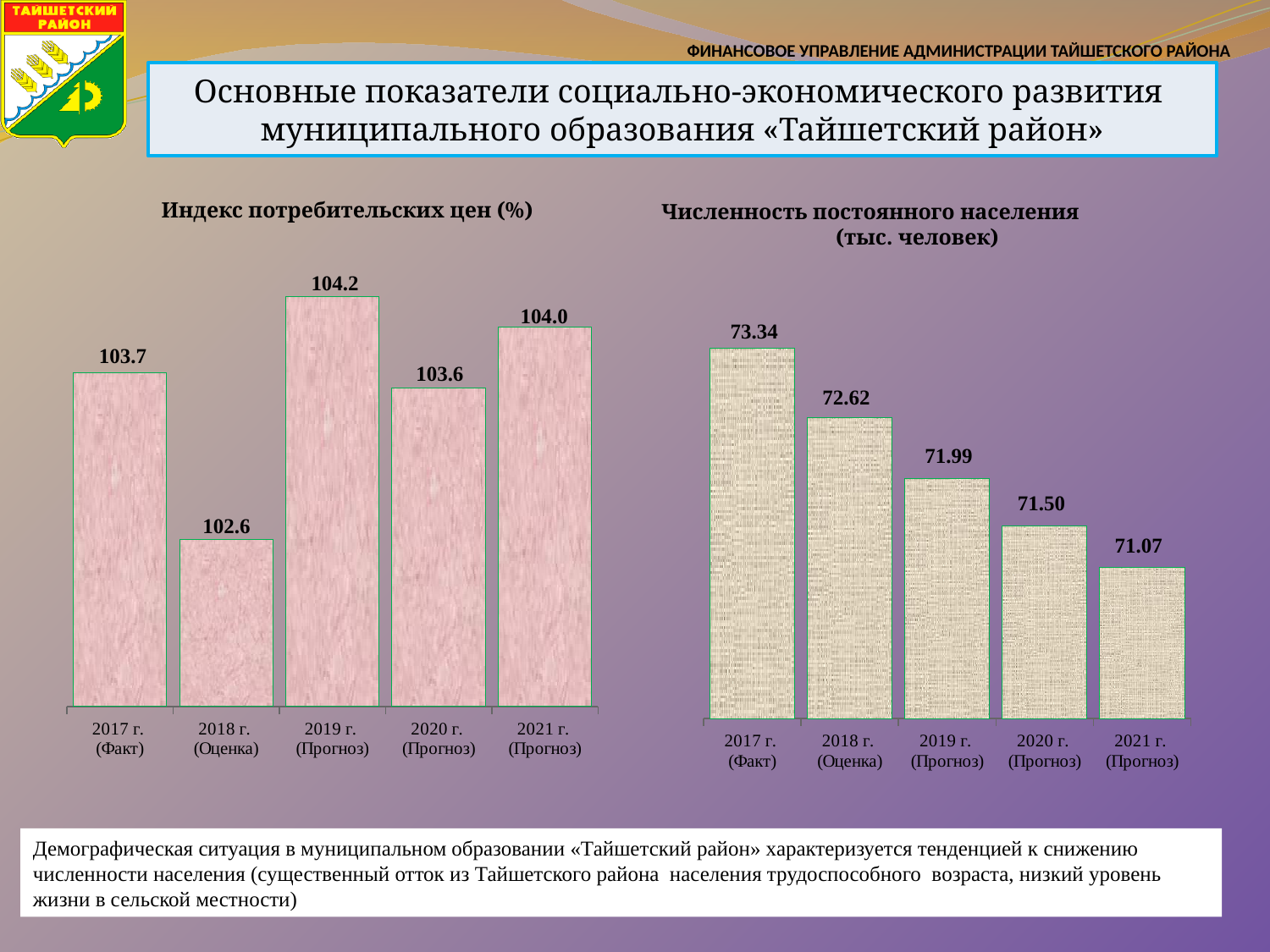
In the chart titled «Индекс потребительских цен (%)», which year has the highest value? 2019 г. (Прогноз) In the chart titled «Индекс потребительских цен (%)», what is the value for 2018 г. (Оценка)? 102.6 In the chart titled «Численность постоянного населения (тыс. человек)», what is the value for 2017 г. (Факт)? 73.34 In the chart titled «Индекс потребительских цен (%)», what is the difference between the values for 2019 г. (Прогноз) and 2018 г. (Оценка)? 1.6 In the chart titled «Численность постоянного населения (тыс. человек)», do the values rise or fall from 2017 to 2021? fall In the chart titled «Численность постоянного населения (тыс. человек)», what is the difference between the values for 2017 г. (Факт) and 2021 г. (Прогноз)? 2.27 In the chart titled «Индекс потребительских цен (%)», which year has the lowest value? 2018 г. (Оценка) What kind of chart is the chart titled «Индекс потребительских цен (%)»? bar chart In the chart titled «Численность постоянного населения (тыс. человек)», which is larger: the value for 2018 г. (Оценка) or 2020 г. (Прогноз)? 2018 г. (Оценка) In the chart titled «Численность постоянного населения (тыс. человек)», which year has the lowest value? 2021 г. (Прогноз) In the chart titled «Индекс потребительских цен (%)», how many bars are plotted? 5 In the chart titled «Численность постоянного населения (тыс. человек)», what is the value for 2021 г. (Прогноз)? 71.07